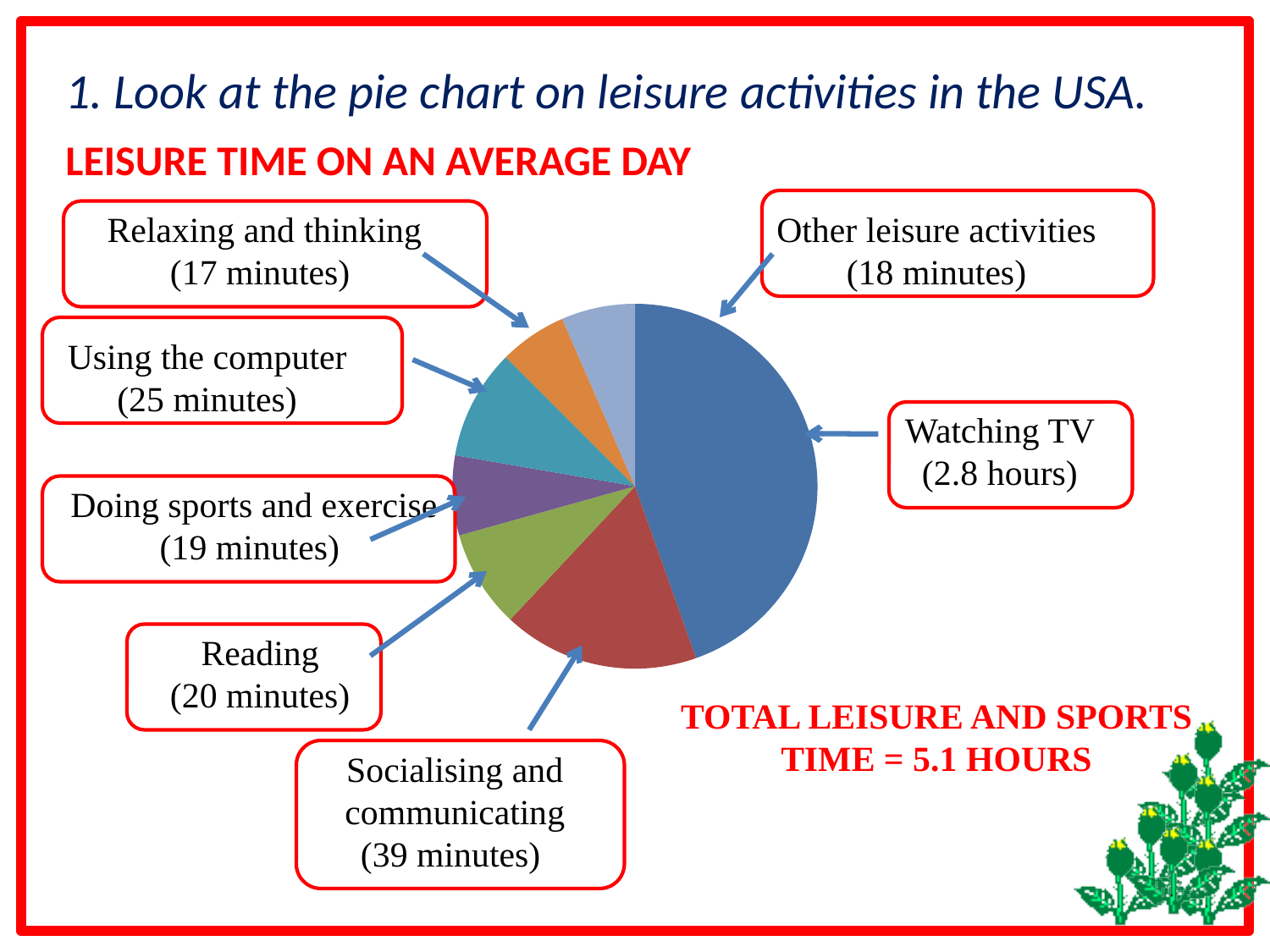
How much time is spent on other leisure activities? 18 minutes How many more minutes are spent socialising and communicating than reading? 19 minutes Which takes more time: using the computer or doing sports and exercise? Using the computer Which activity takes up the least leisure time? Relaxing and thinking How much time is spent watching TV on an average day? 2.8 hours What is the title of the chart? LEISURE TIME ON AN AVERAGE DAY What is the total leisure and sports time stated on the slide? 5.1 hours What kind of chart is shown on the slide? pie chart How much time is spent socialising and communicating? 39 minutes Which activity takes up the largest share of leisure time? Watching TV How many slices does the pie chart have? 7 How much time is spent using the computer? 25 minutes